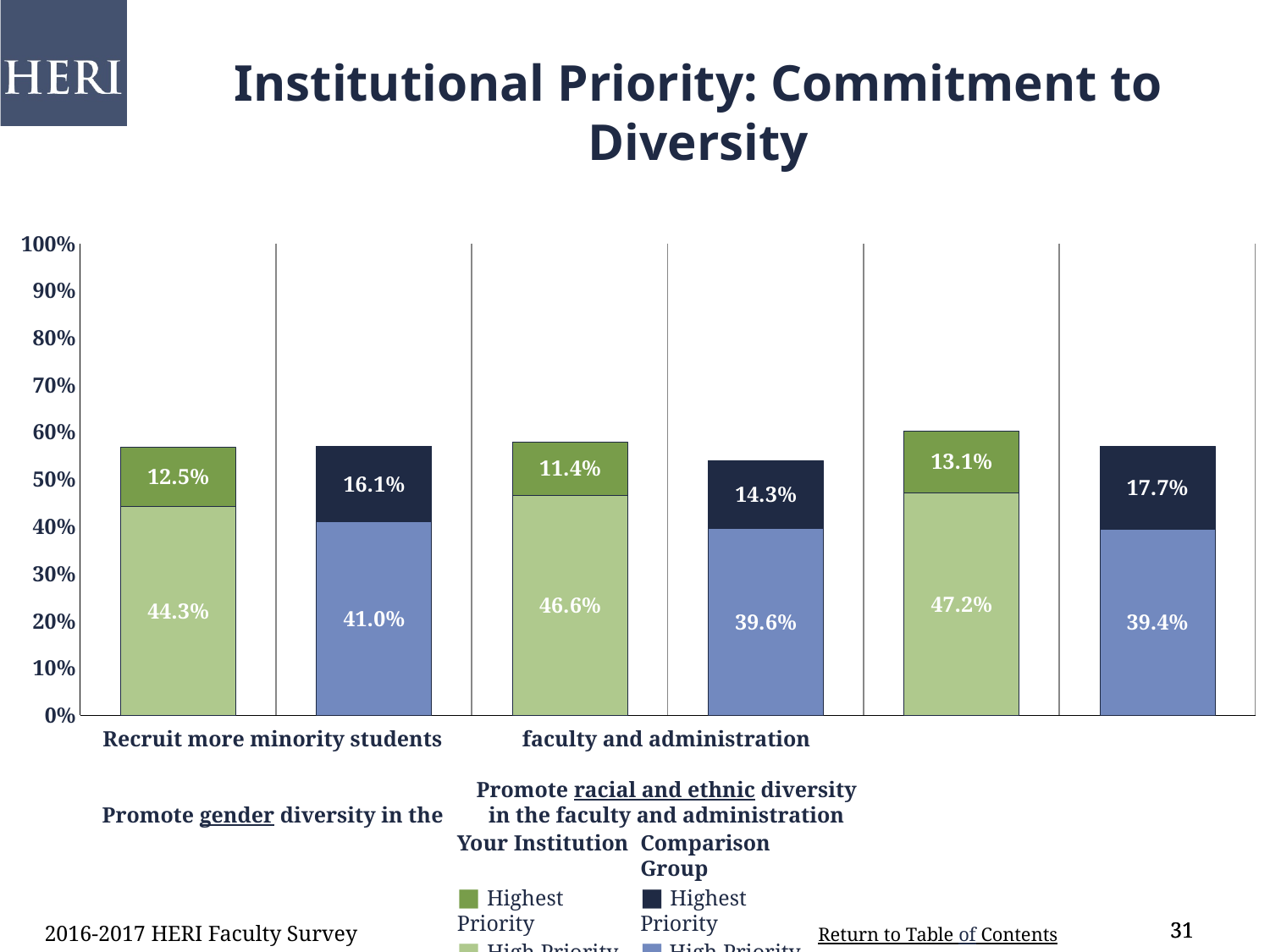
What is the Highest Priority value for the Comparison Group on 'Promote racial and ethnic diversity in the faculty and administration'? 17.7% Which item has the lowest Highest Priority value for Your Institution? Promote gender diversity in the faculty and administration What is the combined Highest Priority and High Priority total for Your Institution on 'Promote racial and ethnic diversity in the faculty and administration'? 60.3% What type of chart is shown on the slide? Stacked bar chart What is the difference between the Comparison Group's and Your Institution's Highest Priority values for 'Recruit more minority students'? 3.6% Which item has the highest High Priority value for Your Institution? Promote racial and ethnic diversity in the faculty and administration What percentage of faculty at Your Institution rated 'Recruit more minority students' as the Highest Priority? 12.5% What is the High Priority value for the Comparison Group on 'Promote gender diversity in the faculty and administration'? 39.6% How many institutional priority items are shown on the x axis of the chart? 3 What is the High Priority value for Your Institution on 'Promote racial and ethnic diversity in the faculty and administration'? 47.2% For 'Promote gender diversity in the faculty and administration', which is larger: the High Priority value for Your Institution or for the Comparison Group? Your Institution What is the combined Highest Priority and High Priority total for the Comparison Group on 'Promote gender diversity in the faculty and administration'? 53.9%